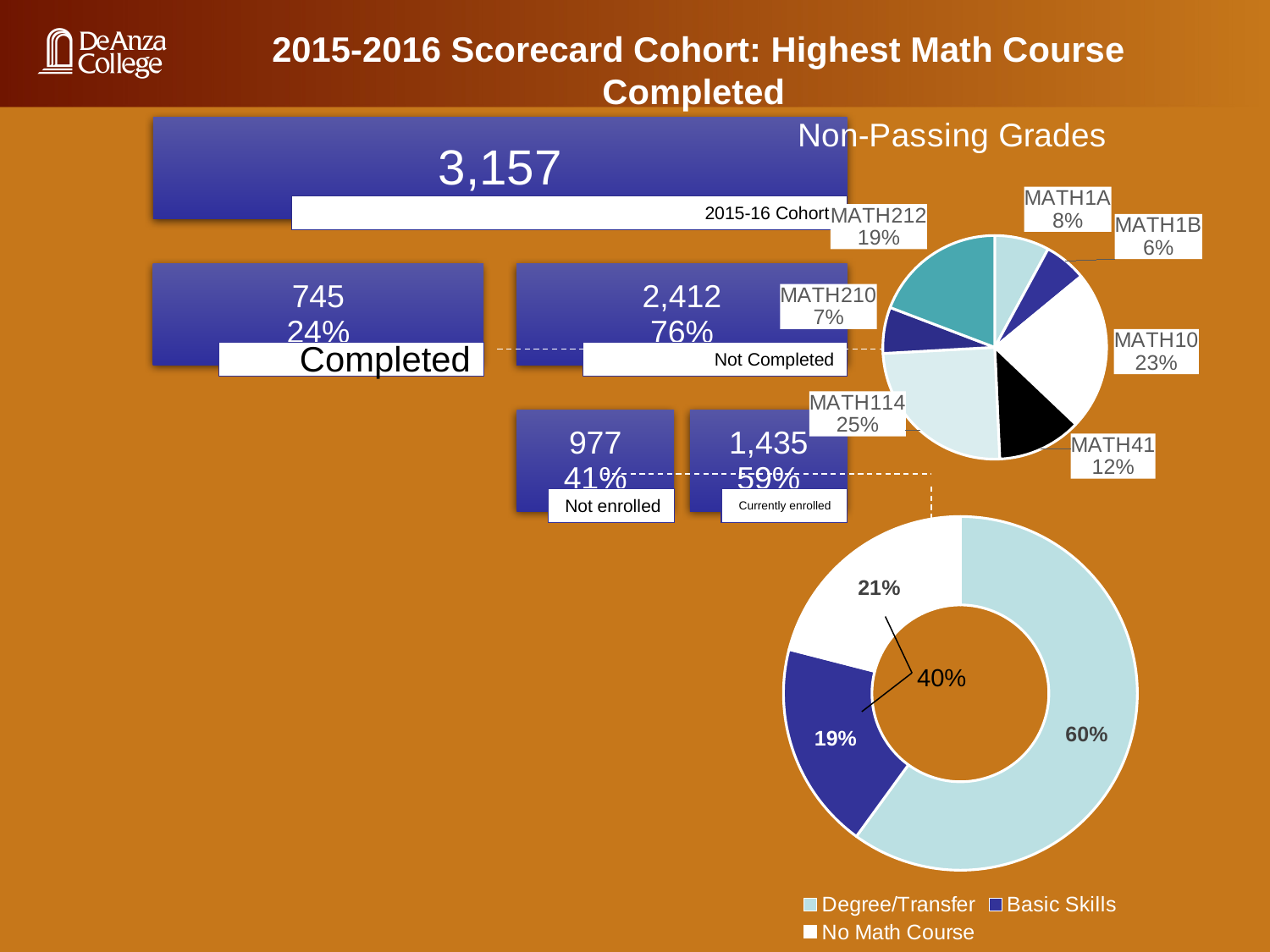
In the Non-Passing Grades pie chart, which course has the largest share? MATH114 In the Non-Passing Grades pie chart, what percentage is shown for MATH114? 25% In the doughnut chart at the bottom right, what percentage is shown for Basic Skills? 19% In the Non-Passing Grades pie chart, what percentage is shown for MATH10? 23% In the doughnut chart at the bottom right, what percentage is shown for Degree/Transfer? 60% In the doughnut chart at the bottom right, how many entries does the legend list? 3 In the Non-Passing Grades pie chart, which course has the smallest share? MATH1B In the Non-Passing Grades pie chart, what is the difference in percentage points between MATH10 and MATH41? 11 In the Non-Passing Grades pie chart, what percentage is shown for MATH212? 19% In the Non-Passing Grades pie chart, which is larger, MATH1A or MATH210? MATH1A What kind of chart is the one at the bottom right of the slide? Doughnut chart In the Non-Passing Grades pie chart, how many courses (slices) are labeled? 7